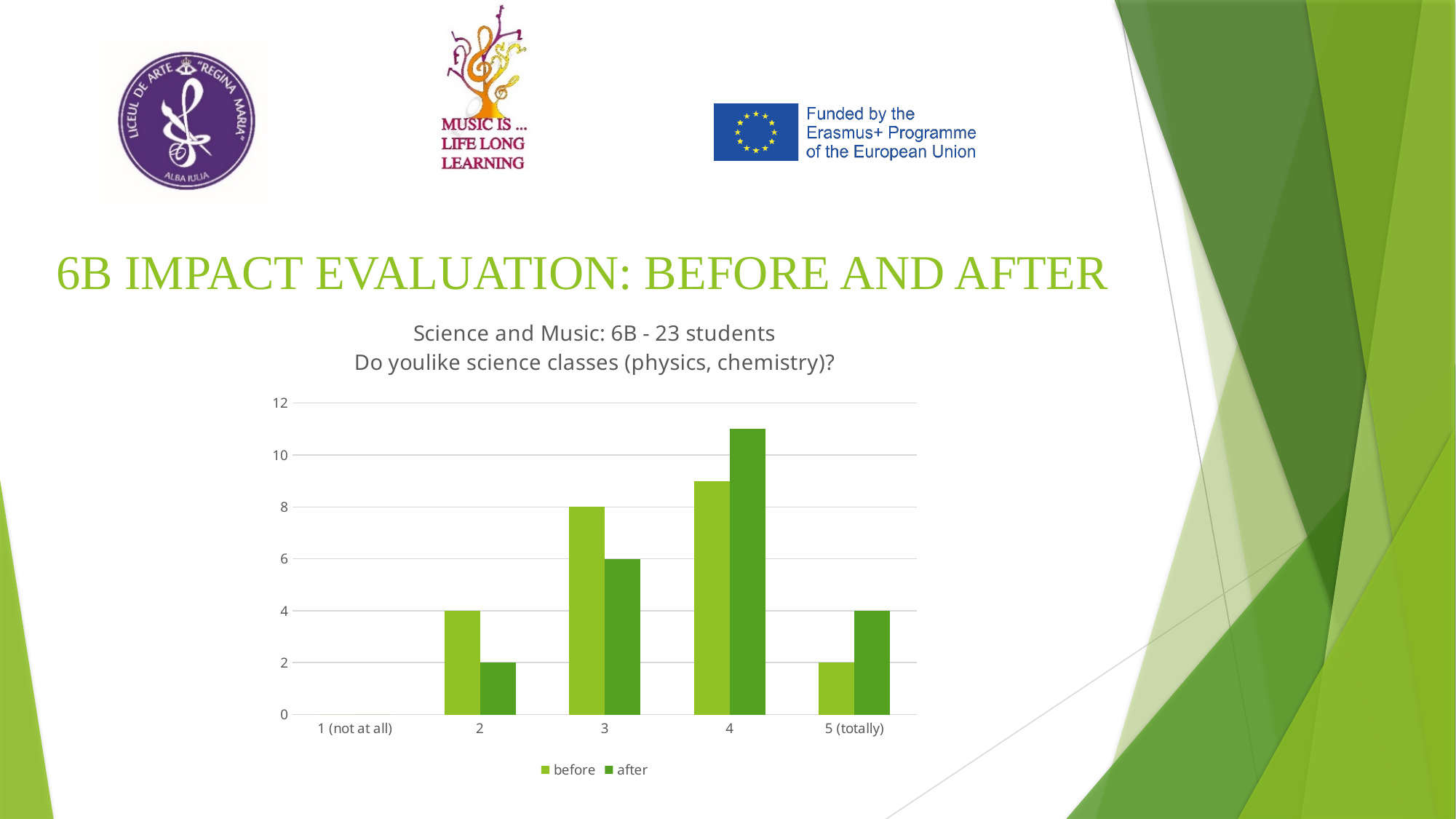
Is the value for 'after' at category 4 greater or less than 10? greater Which category has the highest value for the 'after' series? 4 What is the value for 'after' at category 3? 6 How many series does the legend list? 2 What is the value for 'after' at category 5 (totally)? 4 How many categories are shown on the x axis? 5 What is the value for 'before' at category 2? 4 What is the difference between the 'before' and 'after' values at category 3? 2 What kind of chart is shown on the slide? bar chart At category 4, which series has the larger value, 'before' or 'after'? after What are the two legend entries of the chart? before, after What is the value for 'before' at category 3? 8